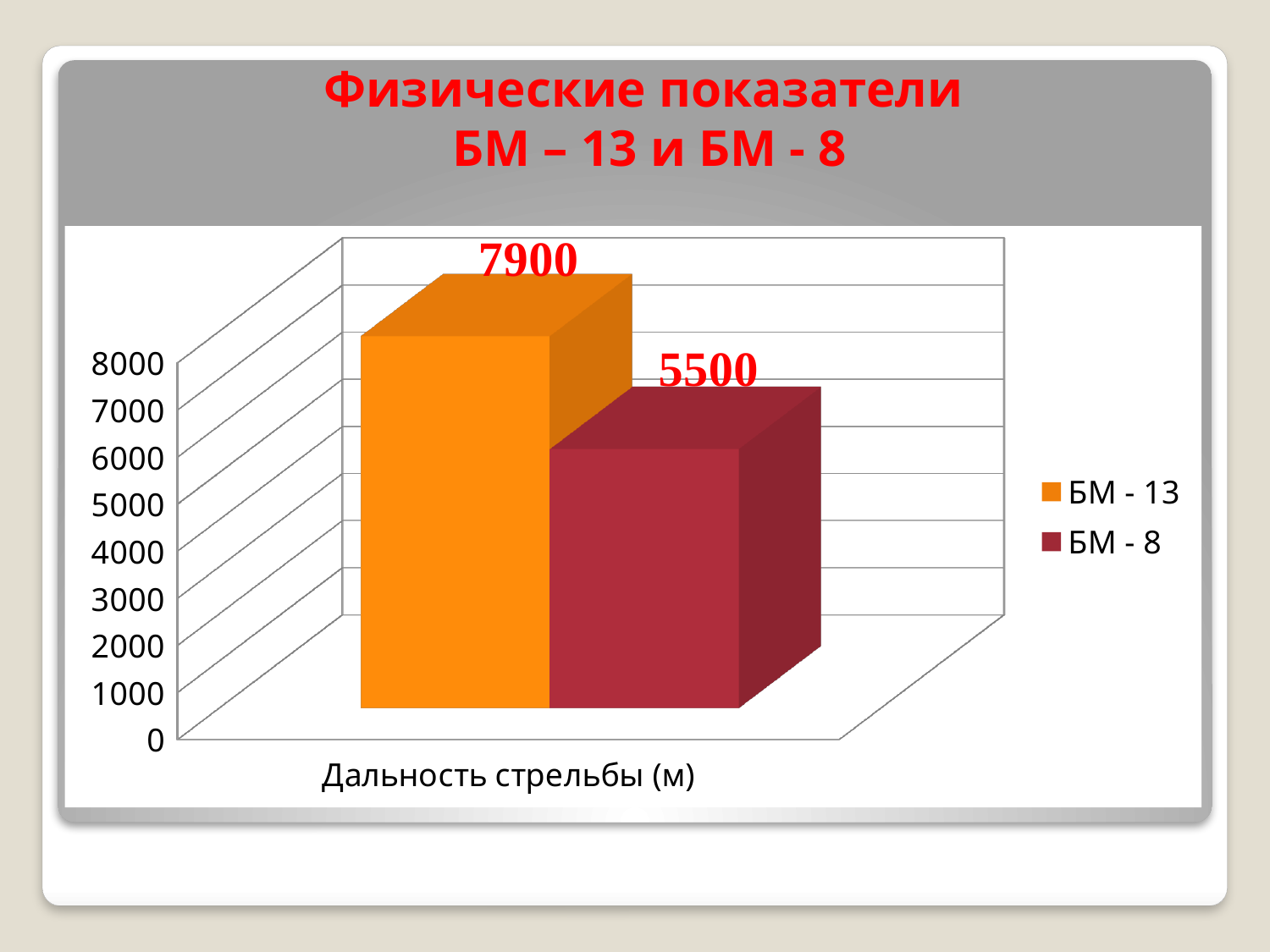
Is the value for БМ - 8 greater or less than 6000? less What is the label on the horizontal axis of the chart? Дальность стрельбы (м) Which series has the higher value, БМ - 13 or БМ - 8? БМ - 13 Which series has the lower value on the chart? БМ - 8 What kind of chart is shown on the slide? bar chart What is the firing range value shown for БМ - 8? 5500 Is the value for БМ - 13 greater or less than 7000? greater What is the highest value shown on the vertical axis? 8000 What colour is the bar for БМ - 13? orange What is the difference between the values for БМ - 13 and БМ - 8? 2400 What is the firing range value shown for БМ - 13? 7900 How many series does the legend list? 2